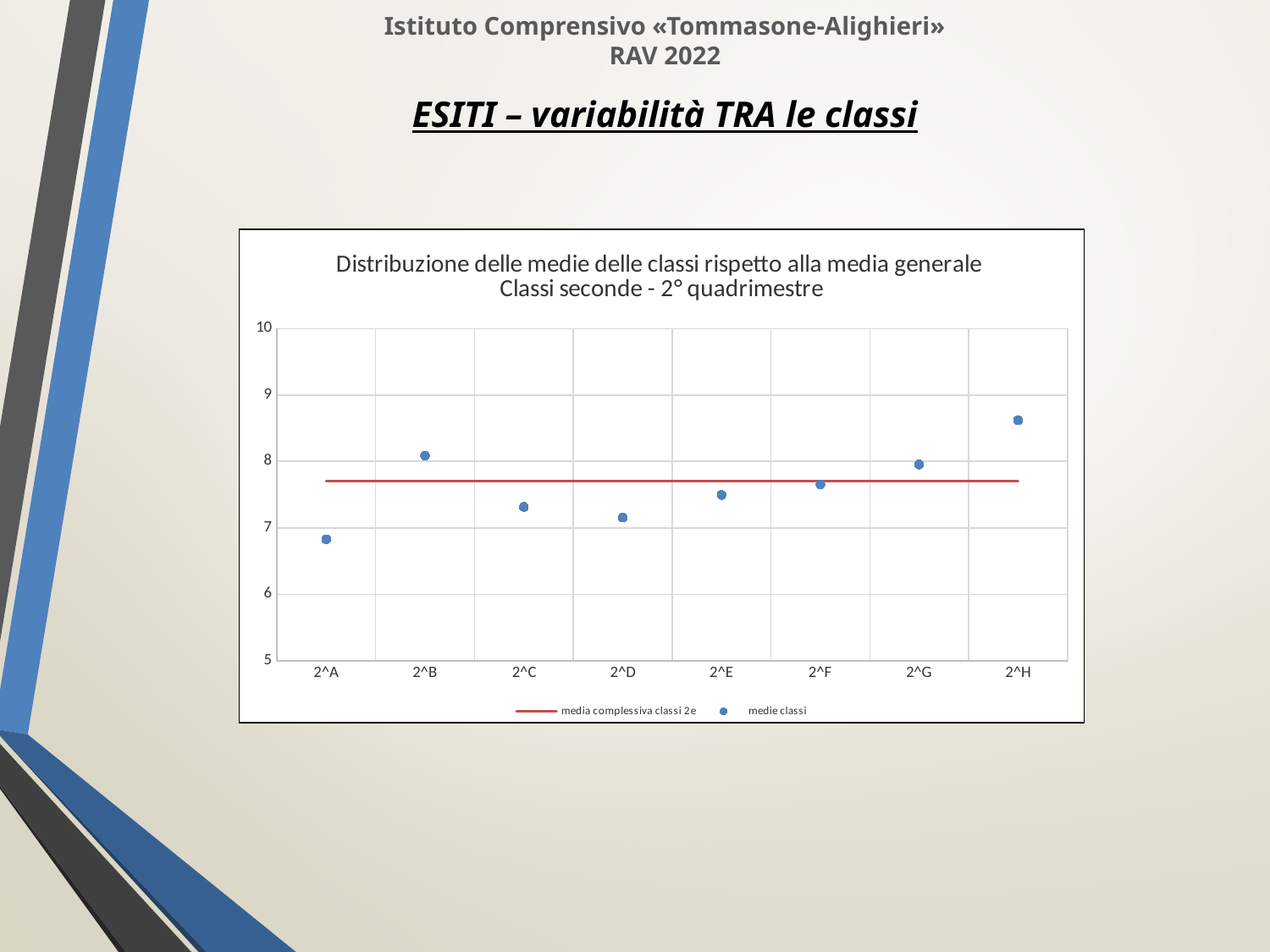
How many series does the chart legend list? 2 Which class has the lowest average in the chart? 2^A Which class has the highest average in the chart? 2^H Which class has the larger average, 2^B or 2^C? 2^B What does the red horizontal line in the chart represent, according to the legend? media complessiva classi 2e What kind of chart is shown on the slide? line chart Is the value for 2^H greater or less than 8? greater Is the value for 2^C greater or less than 8? less Is the value for 2^D greater or less than 7? greater Which class has the larger average, 2^F or 2^D? 2^F How many classes are plotted along the x axis of the chart? 8